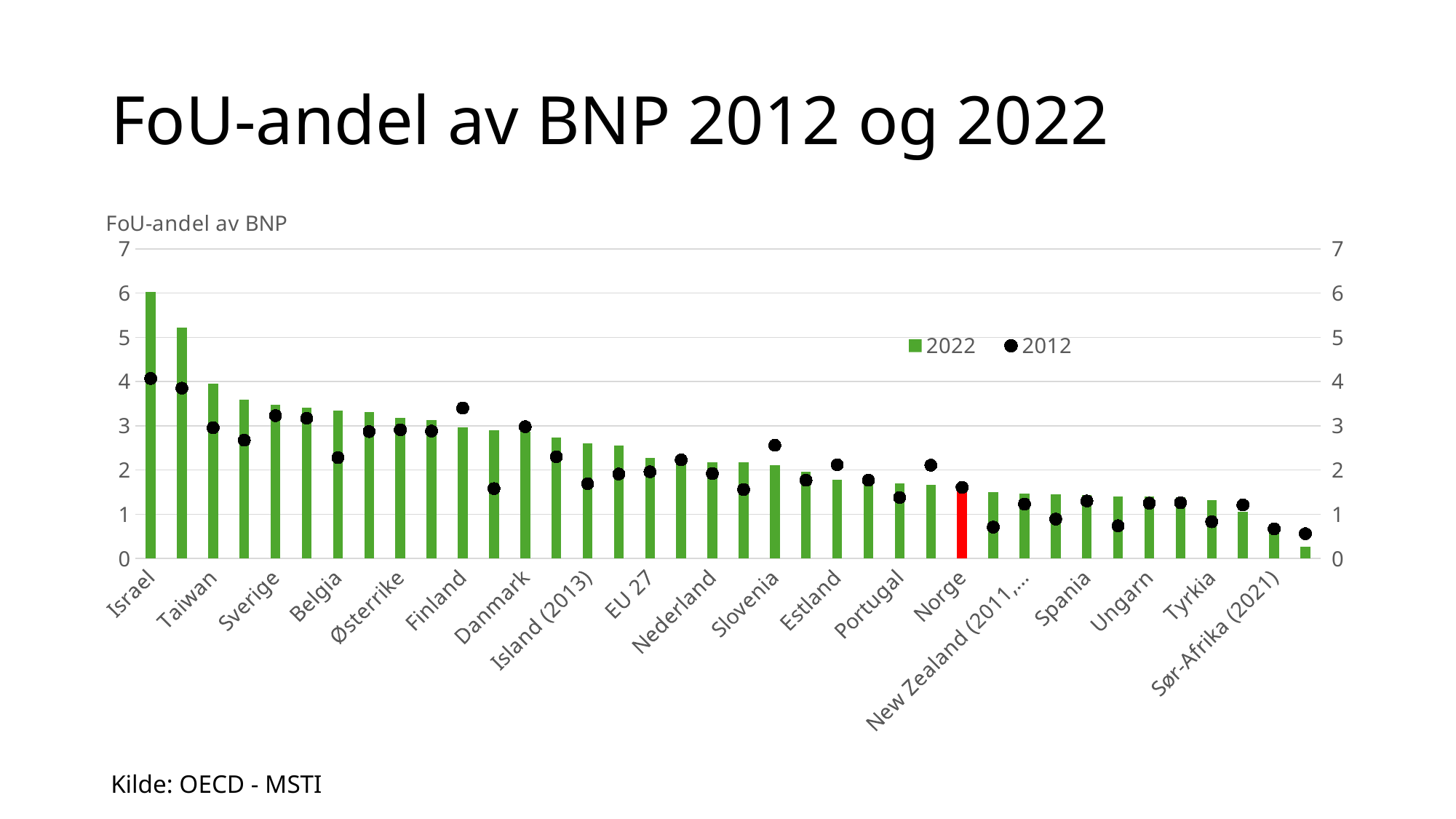
Is the 2022 value for Sør-Afrika (2021) greater or less than 1? less Is the 2022 value for Norge greater or less than 2? less Which country has the highest 2022 bar? Israel Do the 2022 bars rise or fall from left to right along the x axis? fall Which is larger for Slovenia, the 2022 bar or the 2012 dot? 2012 Is the 2012 value for Finland greater or less than 3? greater What kind of chart is shown on the slide? bar chart with dot markers Which has the larger 2022 value, Israel or Taiwan? Israel How many series does the legend list? 2 Which country's 2022 bar is coloured red instead of green? Norge Which is larger for Finland, the 2022 bar or the 2012 dot? 2012